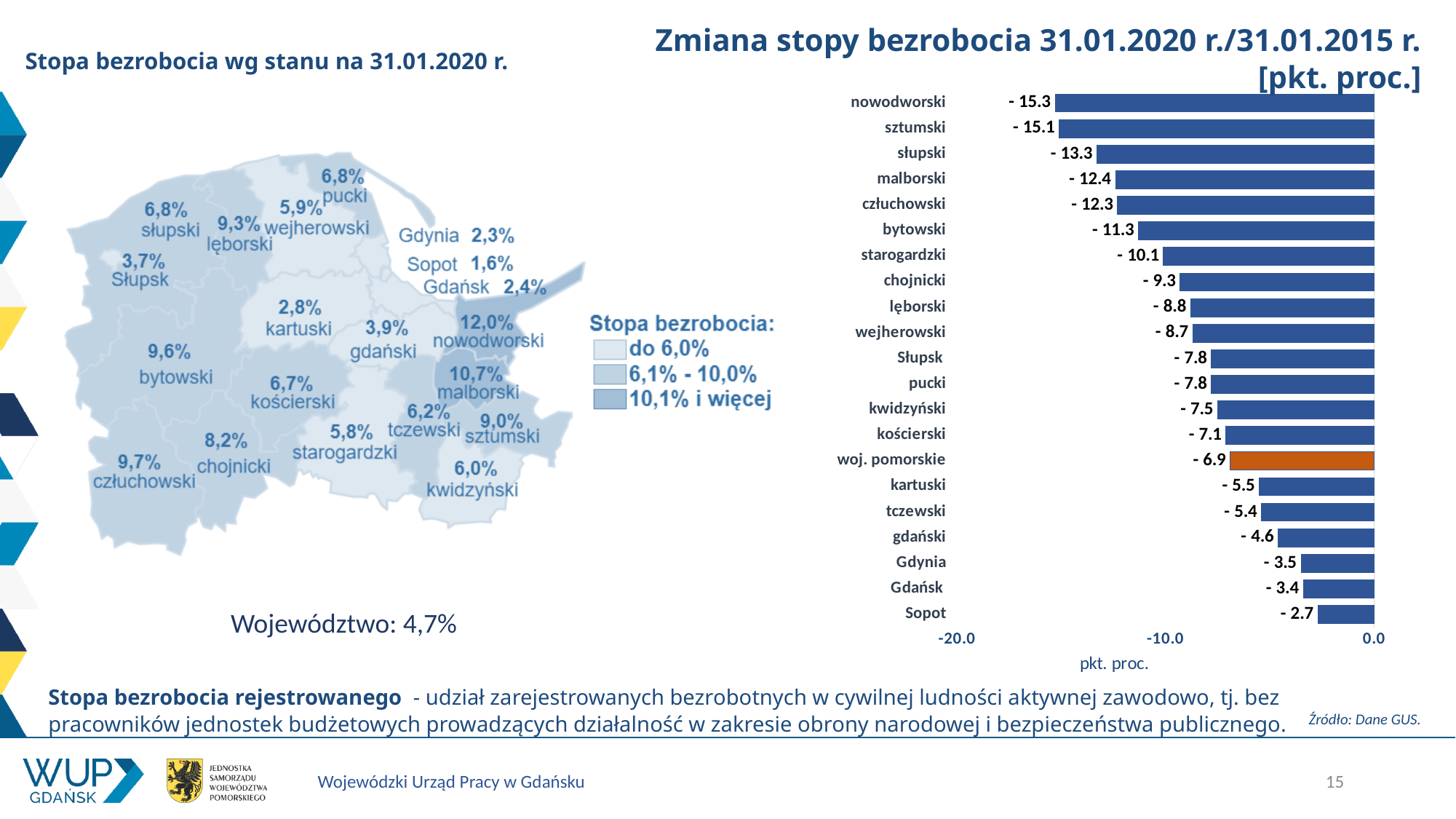
On the bar chart 'Zmiana stopy bezrobocia 31.01.2020 r./31.01.2015 r.', what is the value for woj. pomorskie? - 6.9 On the bar chart 'Zmiana stopy bezrobocia 31.01.2020 r./31.01.2015 r.', which category's bar is shown in a different (orange) colour from the others? woj. pomorskie On the bar chart 'Zmiana stopy bezrobocia 31.01.2020 r./31.01.2015 r.', what is the difference between the values for nowodworski and Sopot? 12.6 On the bar chart 'Zmiana stopy bezrobocia 31.01.2020 r./31.01.2015 r.', is the value for bytowski greater or less than -10.0? less On the bar chart 'Zmiana stopy bezrobocia 31.01.2020 r./31.01.2015 r.', what is the value for Sopot? - 2.7 On the bar chart 'Zmiana stopy bezrobocia 31.01.2020 r./31.01.2015 r.', what unit label is shown below the horizontal axis? pkt. proc. On the bar chart 'Zmiana stopy bezrobocia 31.01.2020 r./31.01.2015 r.', which category shows the largest decrease (the longest bar)? nowodworski What kind of chart is 'Zmiana stopy bezrobocia 31.01.2020 r./31.01.2015 r.'? bar chart On the bar chart 'Zmiana stopy bezrobocia 31.01.2020 r./31.01.2015 r.', which category shows the smallest decrease (the shortest bar)? Sopot On the bar chart 'Zmiana stopy bezrobocia 31.01.2020 r./31.01.2015 r.', which has a larger decrease, sztumski or słupski? sztumski On the bar chart 'Zmiana stopy bezrobocia 31.01.2020 r./31.01.2015 r.', how many categories are plotted? 21 On the bar chart 'Zmiana stopy bezrobocia 31.01.2020 r./31.01.2015 r.', what is the value for nowodworski? - 15.3